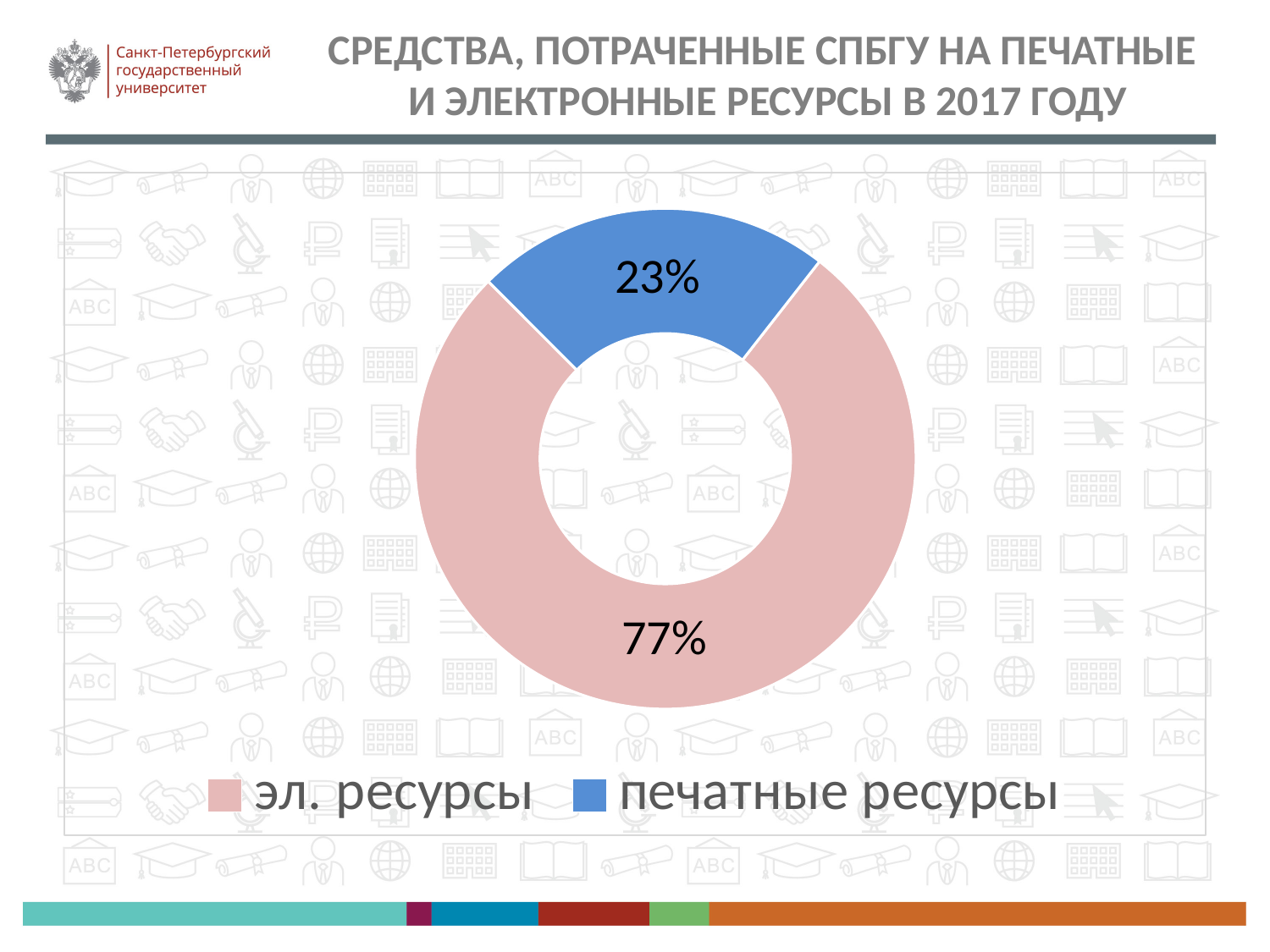
Which category has the largest share in the chart? эл. ресурсы What colour represents печатные ресурсы in the chart? blue How many categories does the chart show? 2 What is the total of the two shares shown in the chart? 100% What share of the chart is taken by эл. ресурсы? 77% Which year does the chart title refer to? 2017 Which is larger: the share for эл. ресурсы or for печатные ресурсы? эл. ресурсы Which category has the smallest share in the chart? печатные ресурсы What is the difference in percentage points between эл. ресурсы and печатные ресурсы? 54 What kind of chart is shown on the slide? doughnut chart What share of the chart is taken by печатные ресурсы? 23%